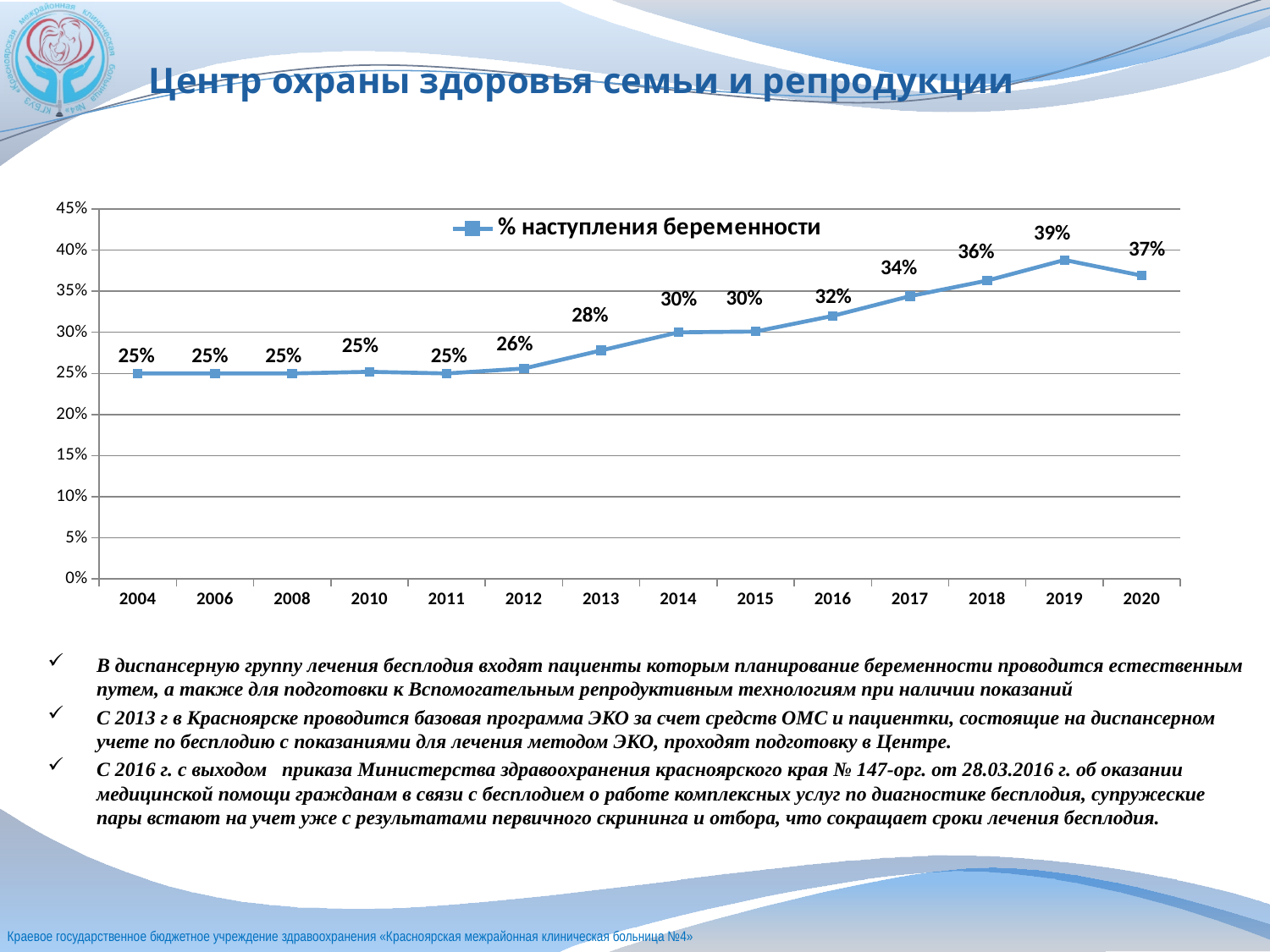
Which year has the highest value? 2019 What is the value for 2013? 28% How many series does the legend list? 1 Which is larger, the value for 2017 or the value for 2014? 2017 What is the difference between the values for 2019 and 2004? 14% What is the difference between the values for 2019 and 2020? 2% What is the name of the series shown in the legend? % наступления беременности What is the value for 2019? 39% What is the value for 2004? 25% What is the value for 2020? 37% What kind of chart is shown on the slide? line chart How many years are plotted on the x axis? 14